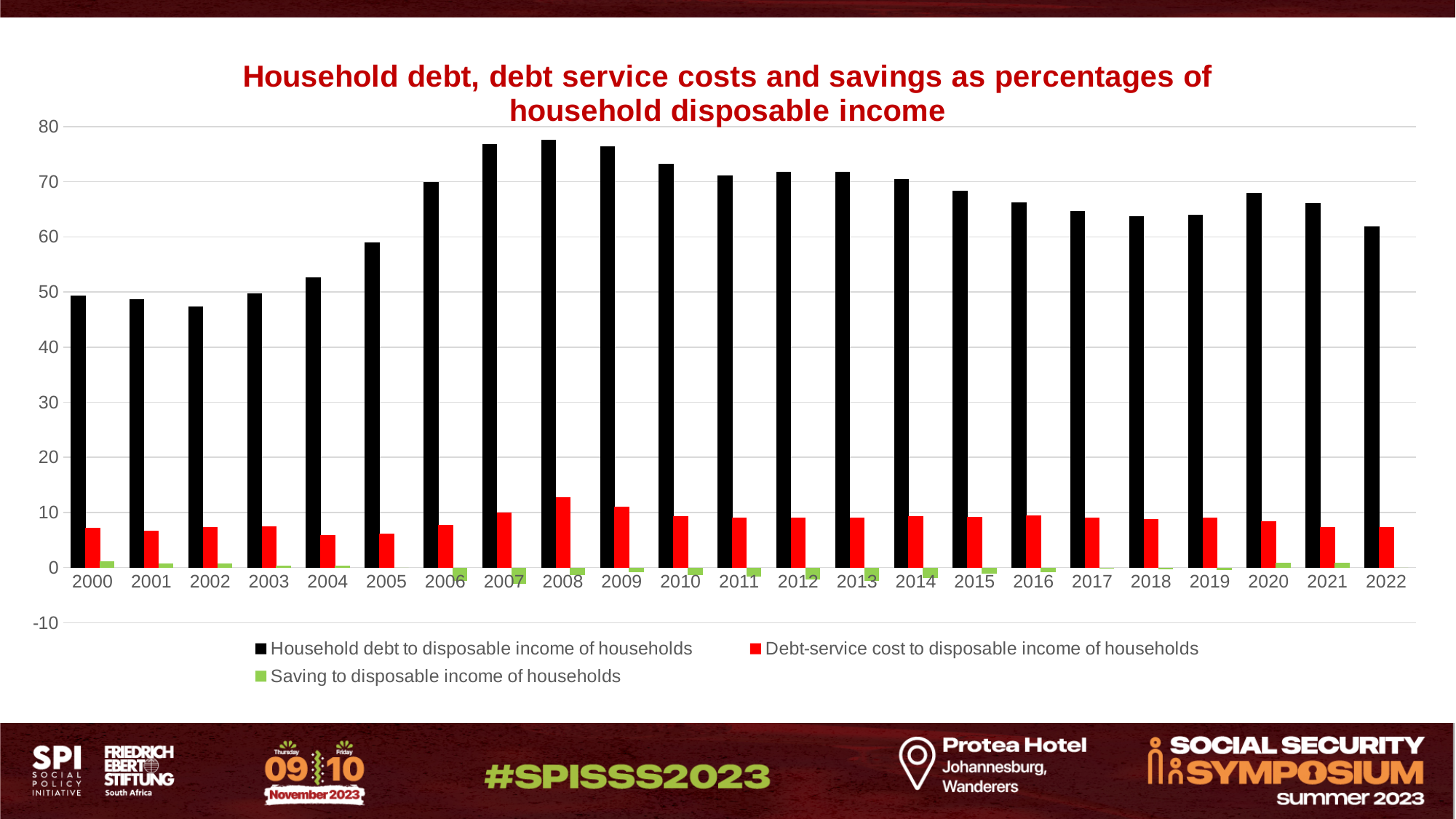
Is the value for Debt-service cost to disposable income of households in 2000 greater or less than 10? less How many years are shown on the x axis? 23 Which year has the lowest value for Saving to disposable income of households? 2007 What kind of chart is shown on the slide? bar chart Does Household debt to disposable income of households rise or fall from 2000 to 2008? rise Which colour represents Saving to disposable income of households in the legend? green Is the value for Debt-service cost to disposable income of households in 2008 greater or less than 10? greater Is the value for Household debt to disposable income of households in 2007 greater or less than 70? greater Which year has the highest value for Debt-service cost to disposable income of households? 2008 Which is larger, Household debt to disposable income of households in 2010 or in 2022? 2010 How many series does the legend list? 3